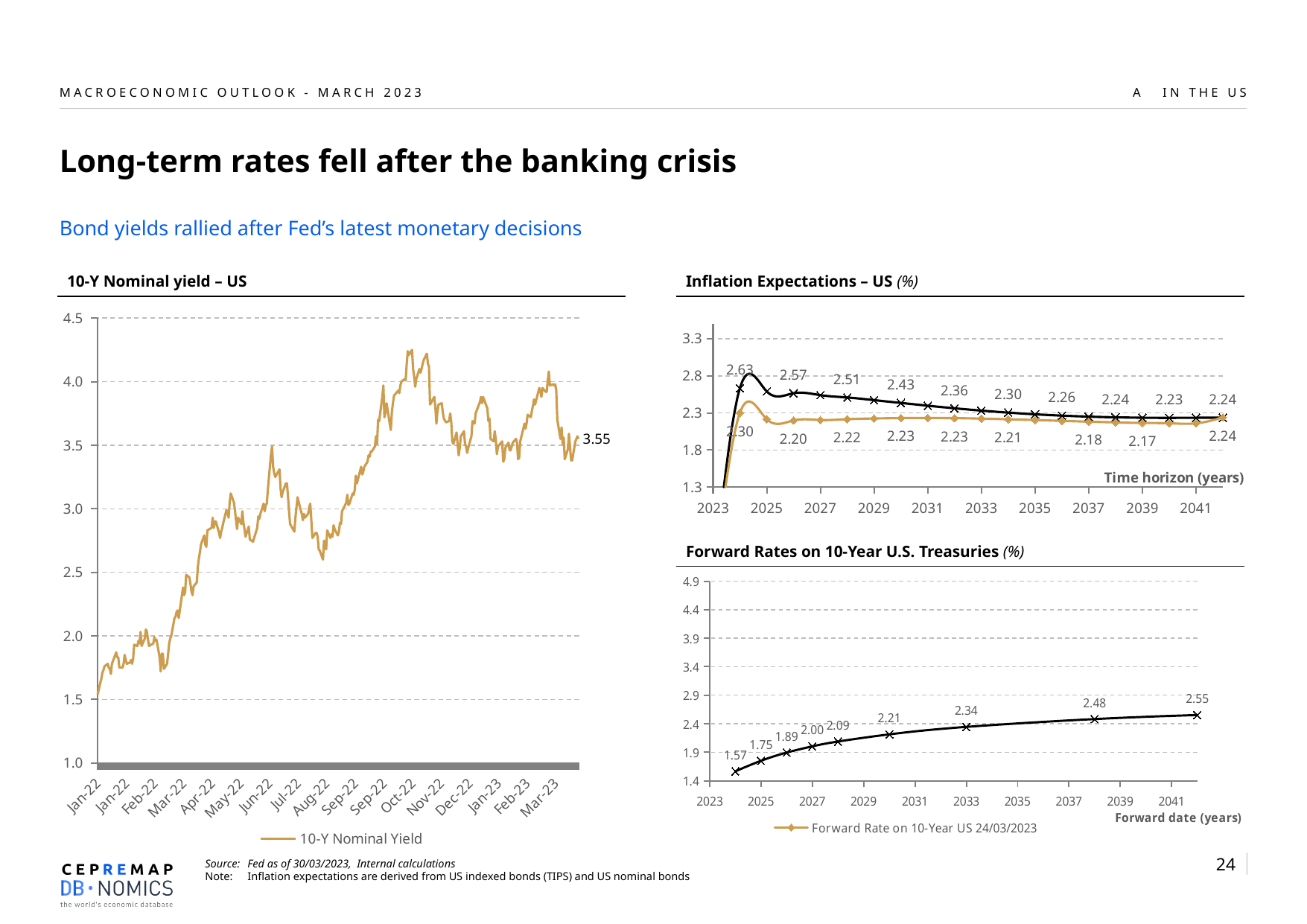
On the 'Forward Rates on 10-Year U.S. Treasuries (%)' chart, what is the difference between the highest labeled value (2.55) and the lowest labeled value (1.57)? 0.98 What kind of chart is the '10-Y Nominal yield – US' chart? line chart On the 'Forward Rates on 10-Year U.S. Treasuries (%)' chart, what is the legend entry for the plotted series? Forward Rate on 10-Year US 24/03/2023 On the 'Forward Rates on 10-Year U.S. Treasuries (%)' chart, what is the forward rate labeled at 2025? 1.75 On the '10-Y Nominal yield – US' chart, is the value at Jan-22 greater or less than 2.0? less On the 'Inflation Expectations – US (%)' chart, what is the highest value labeled on the black line? 2.63 On the '10-Y Nominal yield – US' chart, what is the latest value labeled at the end of the line? 3.55 On the 'Forward Rates on 10-Year U.S. Treasuries (%)' chart, how many labeled data points are there? 9 On the 'Forward Rates on 10-Year U.S. Treasuries (%)' chart, what is the lowest labeled value? 1.57 On the 'Forward Rates on 10-Year U.S. Treasuries (%)' chart, what is the highest labeled value? 2.55 On the '10-Y Nominal yield – US' chart, does the yield overall rise or fall from Jan-22 to Mar-23? rise On the 'Forward Rates on 10-Year U.S. Treasuries (%)' chart, what is the forward rate labeled at 2033? 2.34